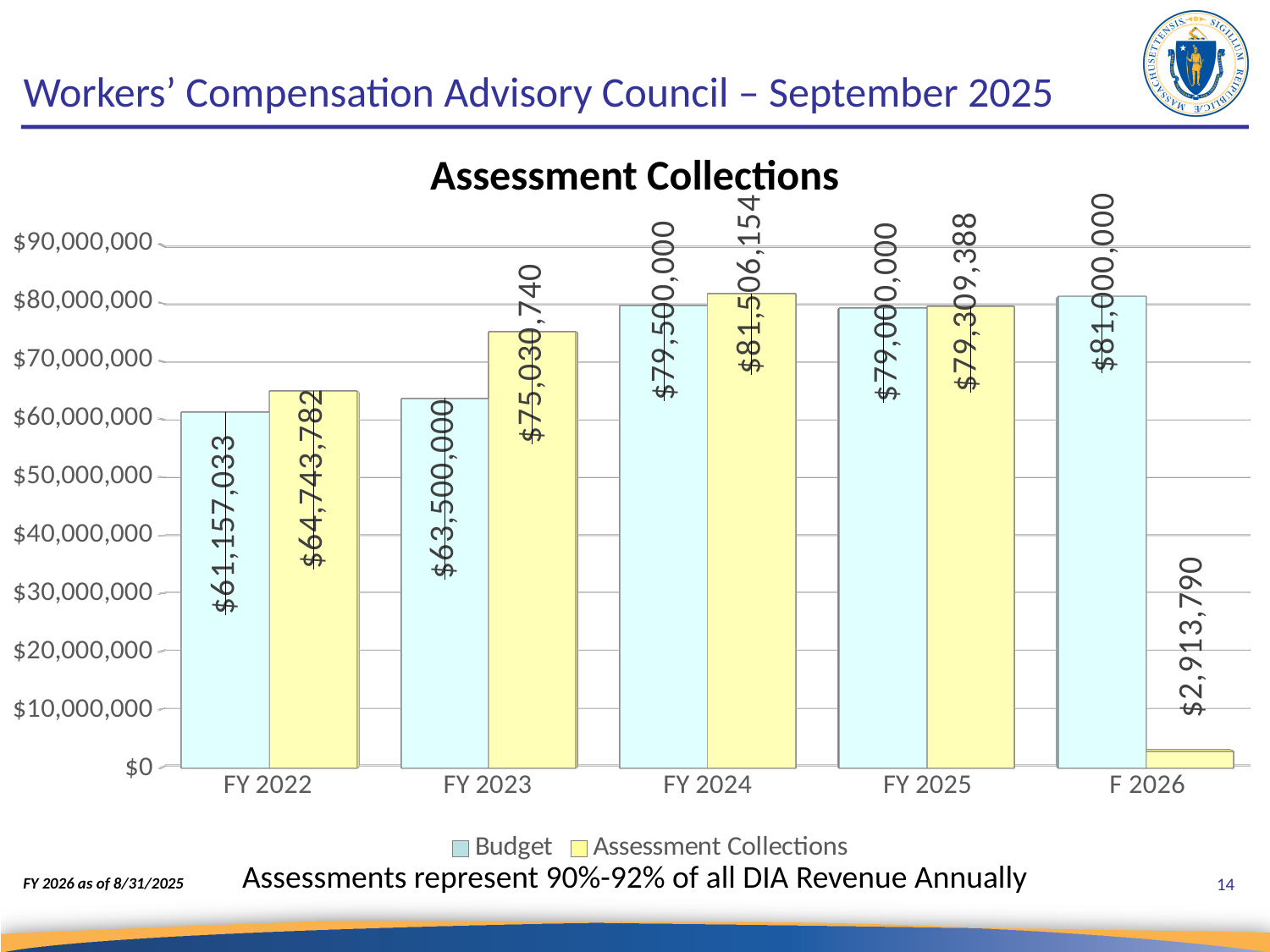
Which fiscal year has the highest Assessment Collections value? FY 2024 In FY 2022, which is larger: the Budget or the Assessment Collections? Assessment Collections Which fiscal year has the highest Budget value? F 2026 Which fiscal year has the lowest Assessment Collections value? F 2026 What is the difference between the Assessment Collections for FY 2024 and FY 2025? $2,196,766 How many series does the legend list? 2 What is the Assessment Collections value for F 2026? $2,913,790 Is the Budget value for FY 2024 greater or less than $70,000,000? greater How many fiscal years are shown on the x axis? 5 By how much do Assessment Collections exceed the Budget in FY 2023? $11,530,740 What is the Assessment Collections value for FY 2023? $75,030,740 What is the Budget value for FY 2022? $61,157,033